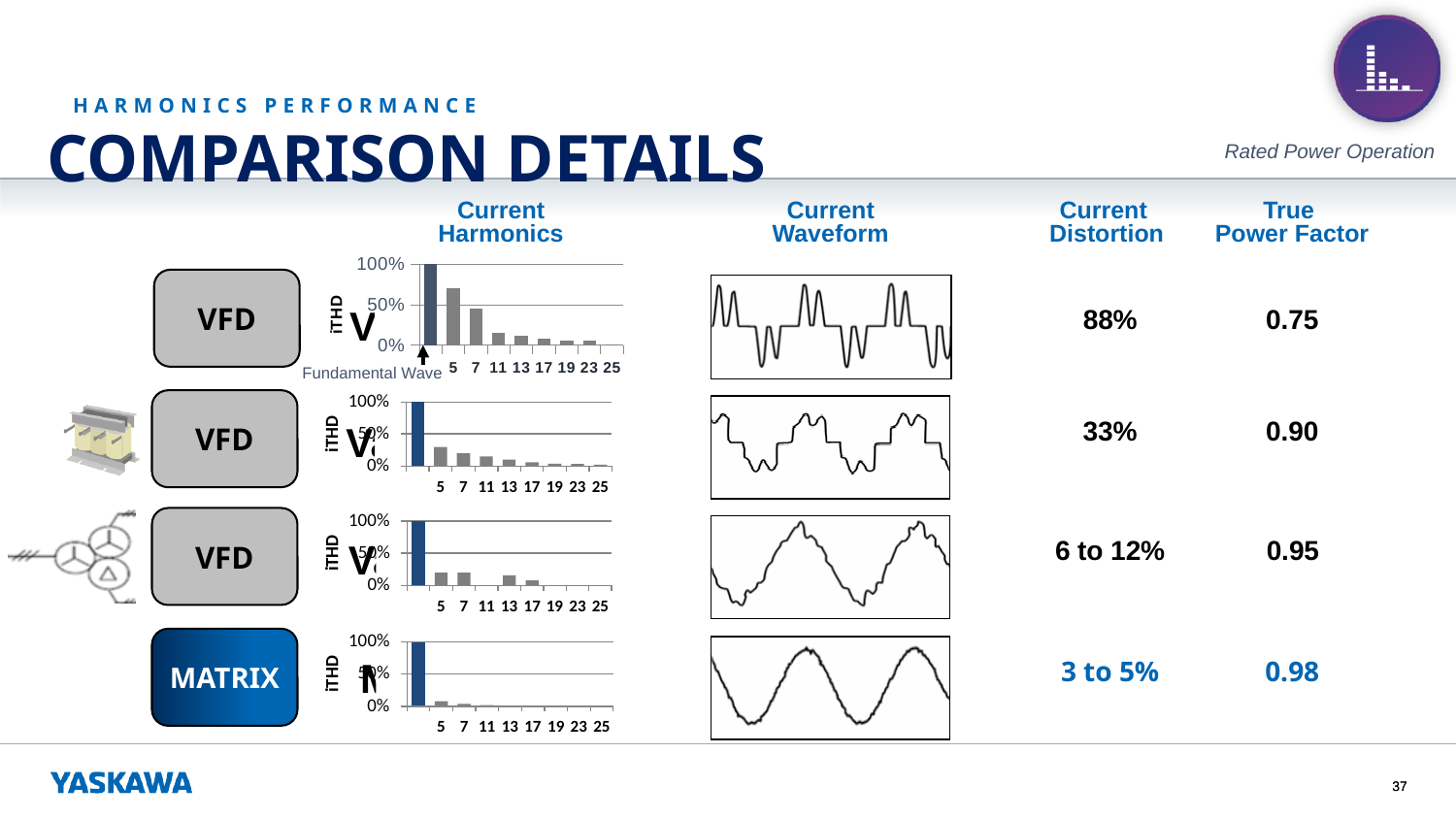
In the top Current Harmonics chart (VFD row), which labeled harmonic order has the highest value? 5 Which is larger, the 5th harmonic value in the top Current Harmonics chart (VFD row) or the 5th harmonic value in the bottom Current Harmonics chart (MATRIX row)? top chart (VFD row) In the top Current Harmonics chart (VFD row), is the value for the 11th harmonic greater or less than 50%? less In the top Current Harmonics chart (VFD row), is the value for the 5th harmonic greater or less than 50%? greater In the second Current Harmonics chart (VFD with reactor row), is the value for the 5th harmonic greater or less than 50%? less What is the label on the y axis of the Current Harmonics charts? iTHD In the top Current Harmonics chart (VFD row), which is larger, the value for the 5th harmonic or the 11th harmonic? 5th harmonic What is the highest value shown on the y axis of the bottom Current Harmonics chart (MATRIX row)? 100% In the top Current Harmonics chart (VFD row), how many harmonic orders are labeled on the x axis? 8 In the top Current Harmonics chart (VFD row), do the harmonic values rise or fall as the harmonic order increases along the x axis? fall What kind of chart is used in the Current Harmonics column for the VFD row at the top? bar chart